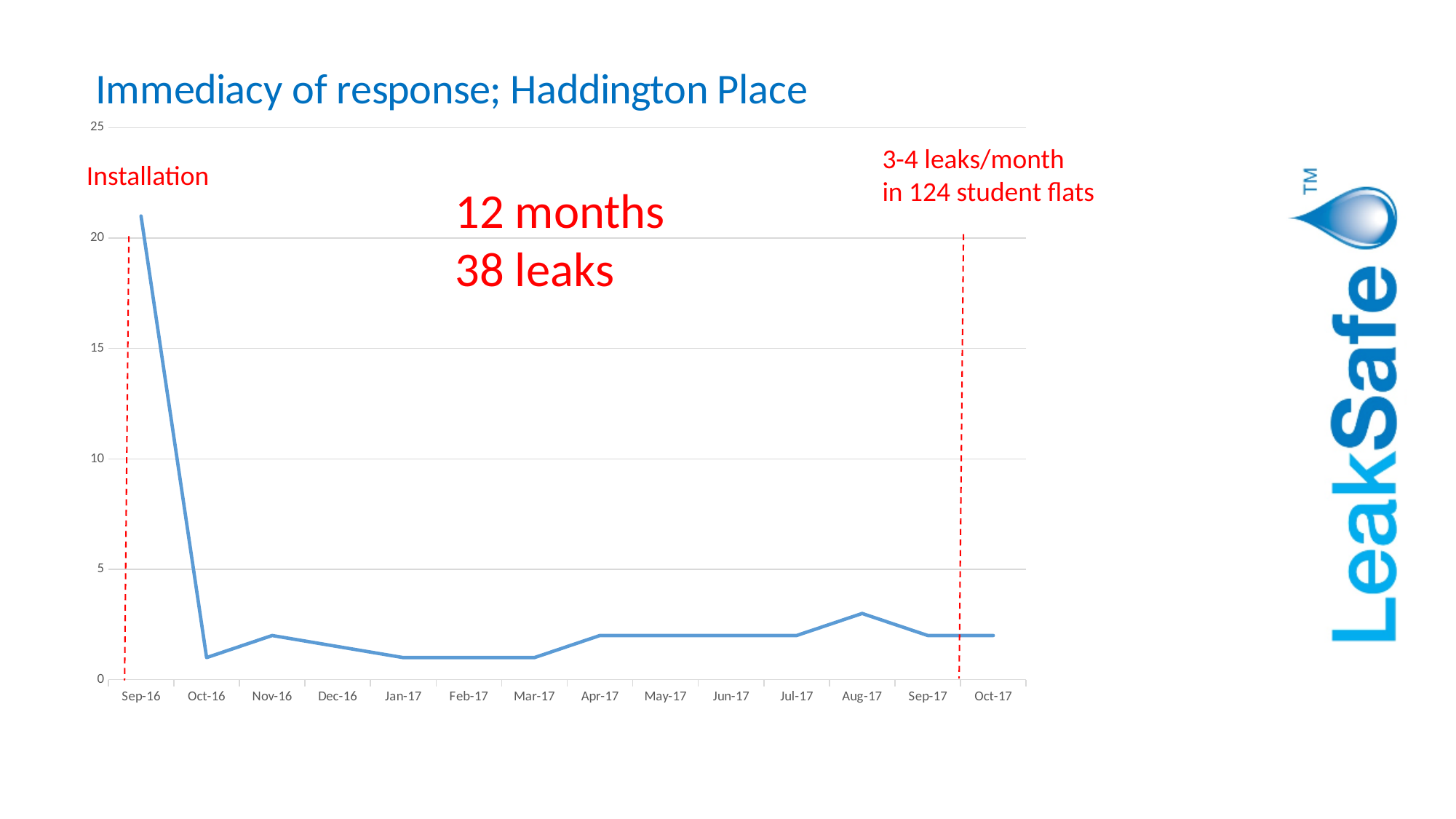
What is the first month shown on the x axis of the chart? Sep-16 Which is larger, the value for Sep-16 or the value for Oct-16? Sep-16 How many months are plotted along the x axis of the chart? 14 Does the line rise or fall between Sep-16 and Oct-16? fall Which is larger, the value for Aug-17 or the value for Jul-17? Aug-17 Is the value for Oct-16 greater or less than 5? less Is the value for Sep-16 greater or less than 25? less Which month has the highest value on the chart? Sep-16 Is the value for Sep-16 greater or less than 20? greater What is the title of the slide's chart? Immediacy of response; Haddington Place What kind of chart is shown on the slide? line chart